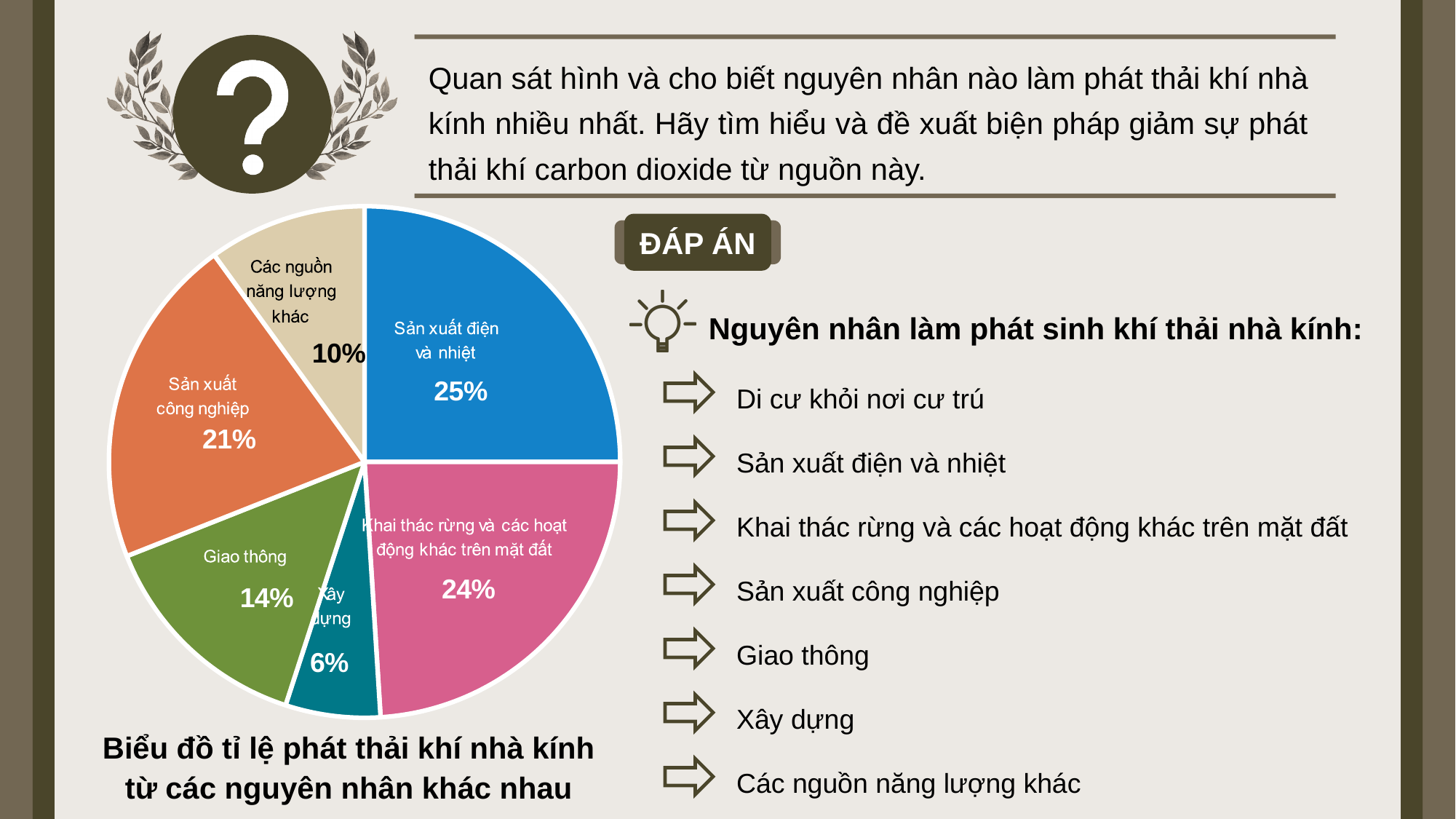
What value is labelled on the "Các nguồn năng lượng khác" slice? 10% What colour is the "Giao thông" slice in the pie chart? Green What percentage is shown for "Sản xuất công nghiệp"? 21% What percentage of greenhouse gas emissions does the chart attribute to "Sản xuất điện và nhiệt"? 25% How many categories are shown in the pie chart? 6 What is the difference between the shares of "Sản xuất công nghiệp" and "Giao thông"? 7% What kind of chart is shown on the slide? Pie chart Which category has the largest slice in the pie chart? Sản xuất điện và nhiệt What is the value shown for "Giao thông" in the pie chart? 14% What share does "Xây dựng" have in the pie chart? 6% Which is larger: the share for "Khai thác rừng và các hoạt động khác trên mặt đất" or the share for "Sản xuất công nghiệp"? Khai thác rừng và các hoạt động khác trên mặt đất Which category has the smallest slice in the pie chart? Xây dựng